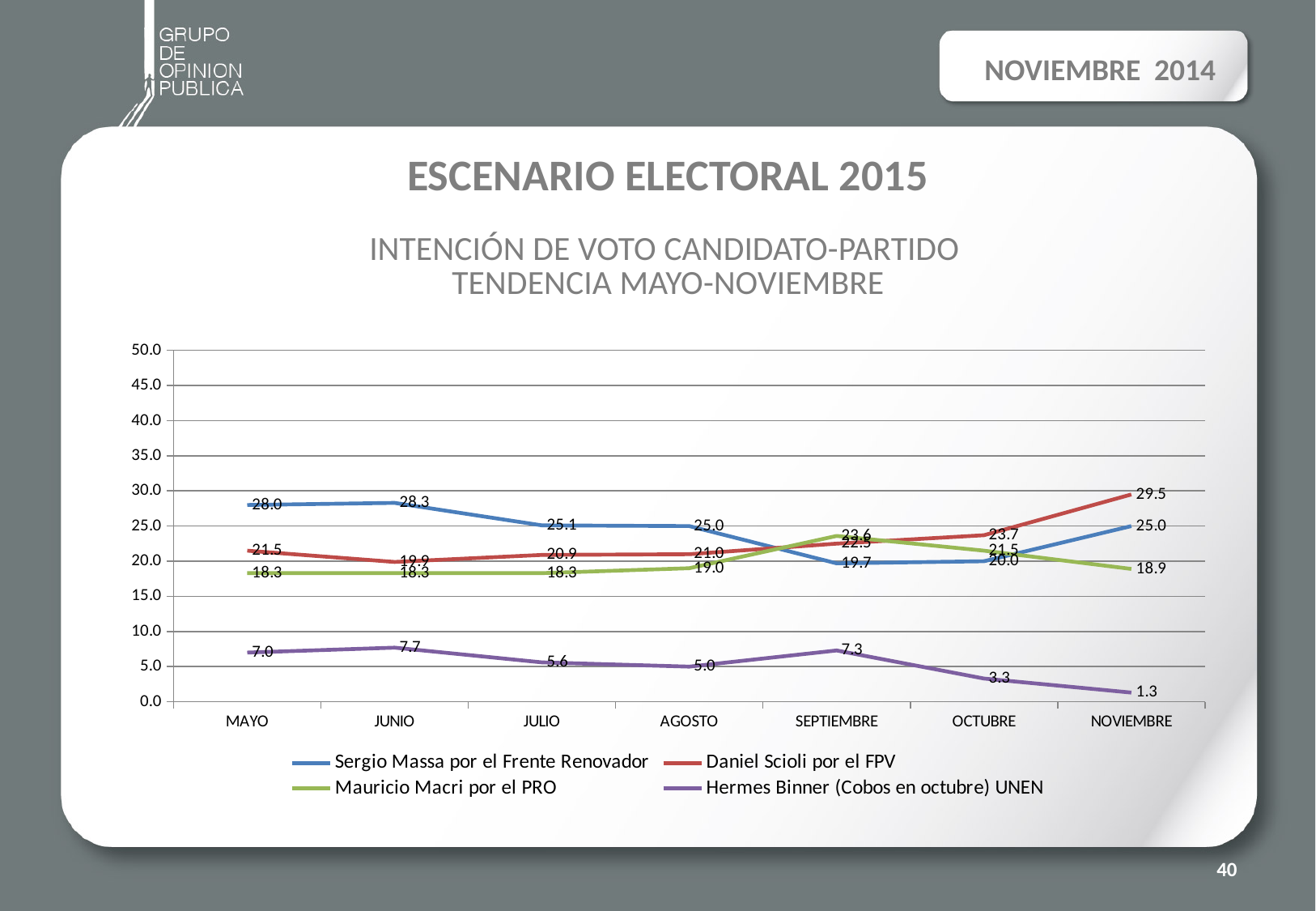
What is the value for Daniel Scioli por el FPV in NOVIEMBRE? 29.5 What is the value for Hermes Binner (Cobos en octubre) UNEN in NOVIEMBRE? 1.3 What kind of chart is shown on the slide? line chart Is the value for Hermes Binner (Cobos en octubre) UNEN in OCTUBRE greater or less than 5.0? less How many months are shown on the x axis? 7 How many series does the legend list? 4 In which month does Hermes Binner (Cobos en octubre) UNEN have its lowest value? NOVIEMBRE What is the difference between Sergio Massa's value in JUNIO and in MAYO? 0.3 In which month does Hermes Binner (Cobos en octubre) UNEN reach its highest value? JUNIO What is the value for Sergio Massa por el Frente Renovador in MAYO? 28.0 In NOVIEMBRE, which is larger: the value for Daniel Scioli por el FPV or for Sergio Massa por el Frente Renovador? Daniel Scioli por el FPV Does the line for Hermes Binner (Cobos en octubre) UNEN rise or fall from SEPTIEMBRE to NOVIEMBRE? fall